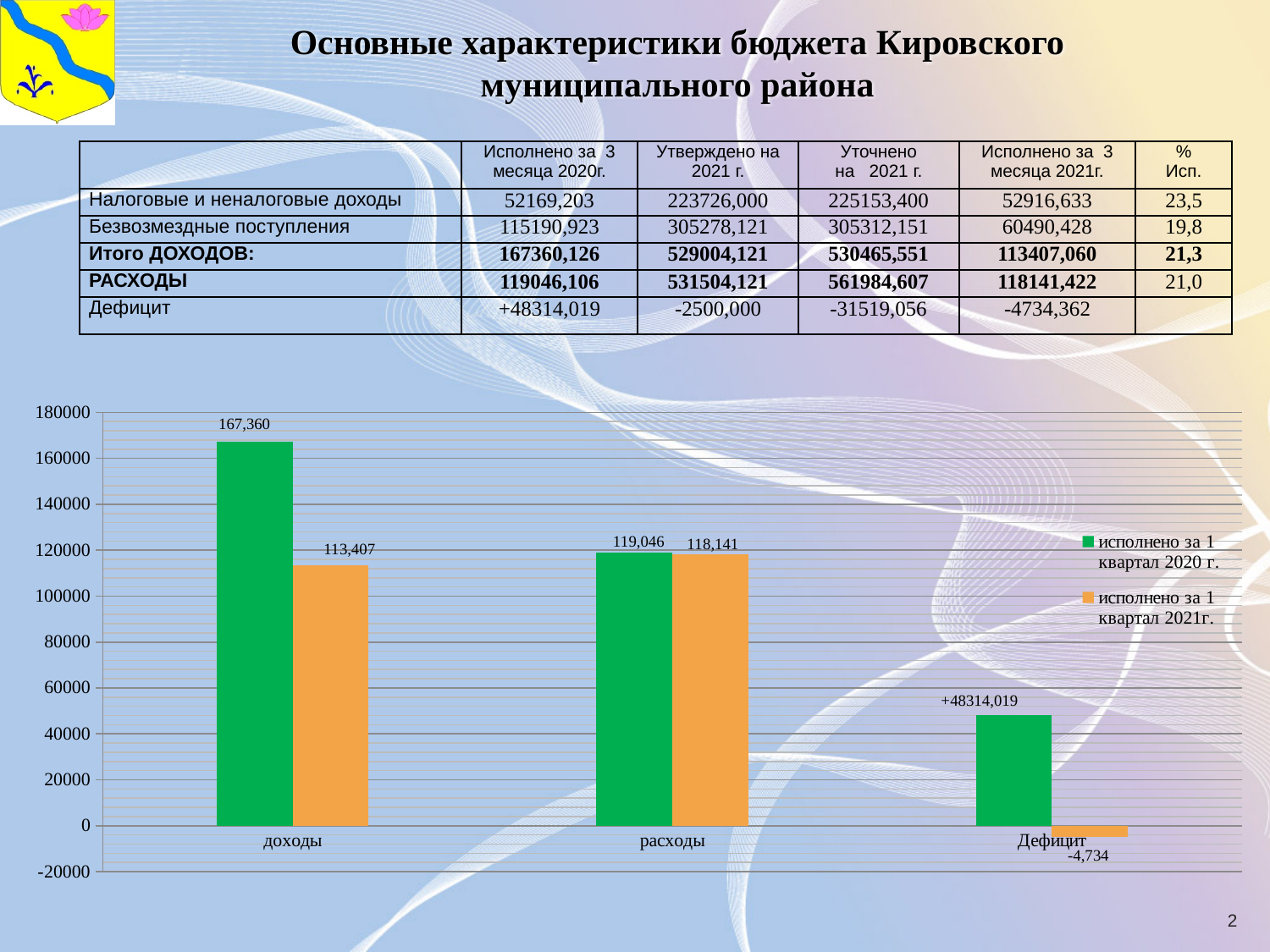
How many series does the chart legend list? 2 How many categories are shown on the x axis of the chart? 3 What is the value for Дефицит in the series исполнено за 1 квартал 2021г.? -4,734 Which category has the highest value in the series исполнено за 1 квартал 2020 г.? доходы What is the value for доходы in the series исполнено за 1 квартал 2020 г.? 167,360 What is the value for расходы in the series исполнено за 1 квартал 2020 г.? 119,046 What is the value for доходы in the series исполнено за 1 квартал 2021г.? 113,407 What kind of chart is shown on the slide? bar chart What is the value for расходы in the series исполнено за 1 квартал 2021г.? 118,141 Is the value for доходы in the series исполнено за 1 квартал 2021г. greater or less than 100000? greater Which category has the lowest value in the series исполнено за 1 квартал 2021г.? Дефицит What is the difference between the доходы values for исполнено за 1 квартал 2020 г. and исполнено за 1 квартал 2021г.? 53,953